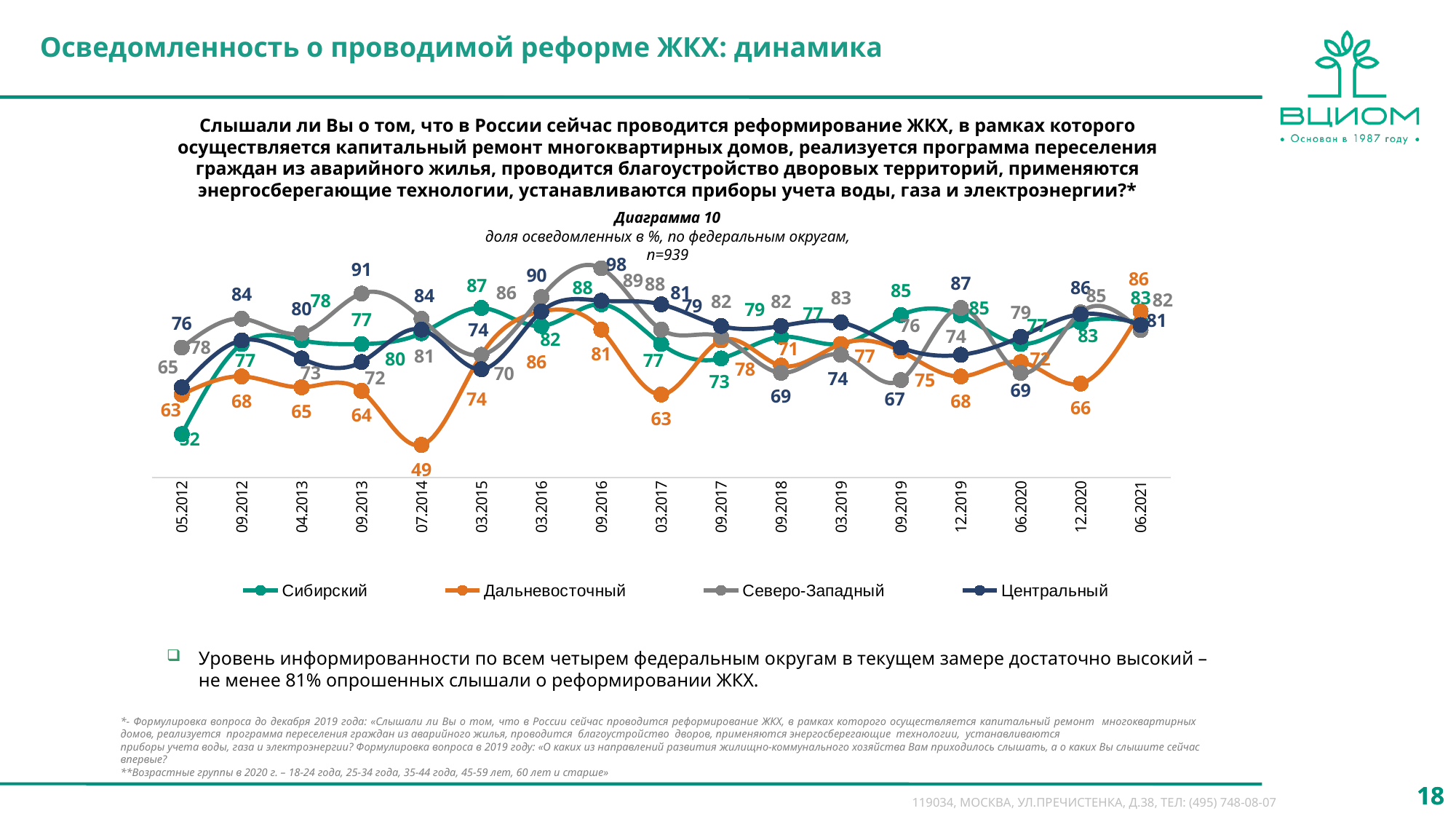
What is the value for Дальневосточный at 06.2021? 86 What is the value for Сибирский at 03.2015? 87 What kind of chart is shown on the slide? line chart What is the difference between the Дальневосточный values at 06.2021 and 07.2014? 37 What is the number of the diagram given in the chart title? Диаграмма 10 At which time point does Дальневосточный reach its lowest value? 07.2014 At 05.2012, which is larger: Сибирский or Дальневосточный? Дальневосточный What is the value for Сибирский at 05.2012? 52 How many series does the legend list? 4 At which time point does Дальневосточный reach its highest value? 03.2016 and 06.2021 What is the value for Дальневосточный at 07.2014? 49 How many time points are shown on the x axis? 17